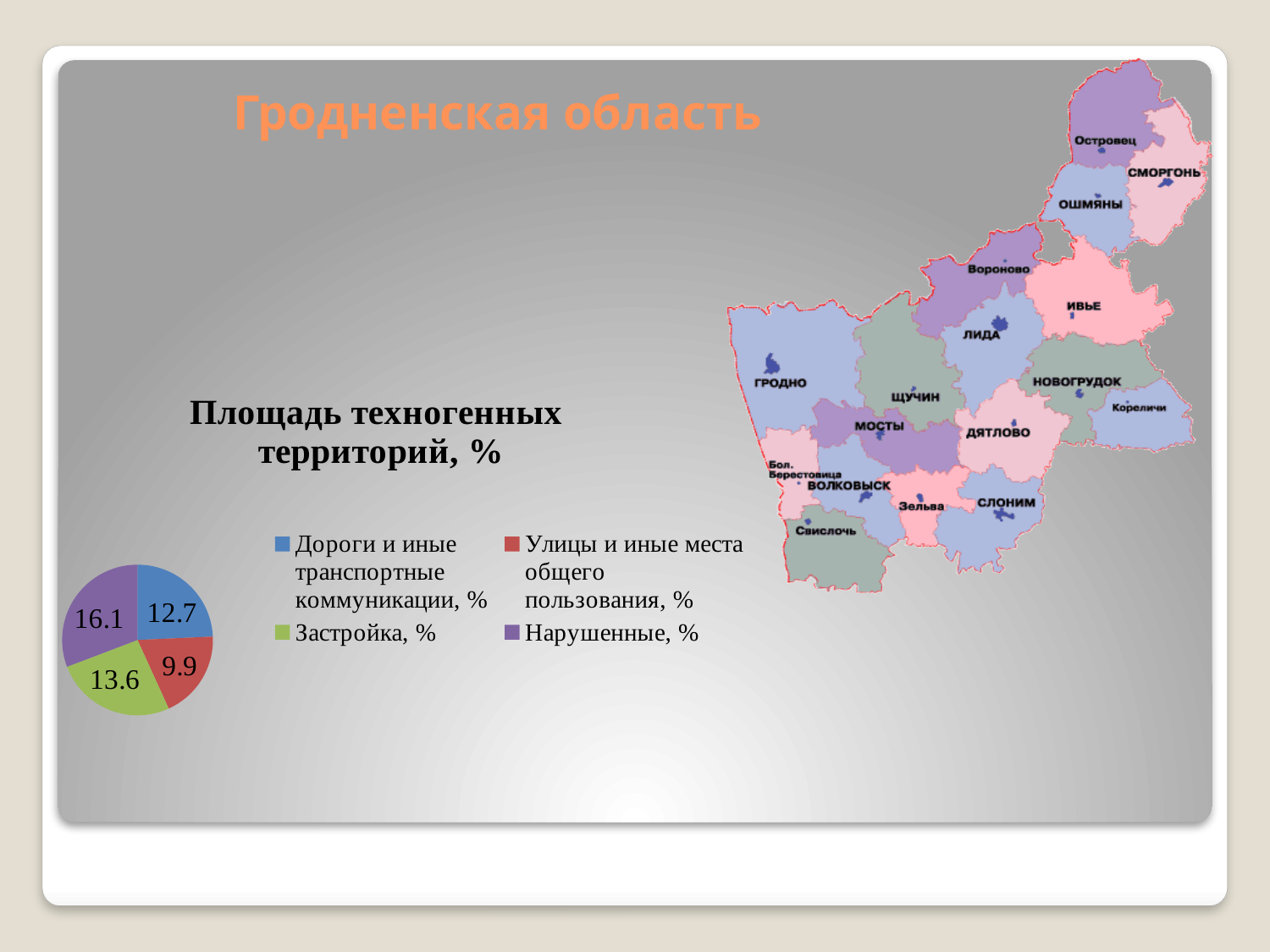
How many slices does the pie chart have? 4 What is the value for Дороги и иные транспортные коммуникации, % in the pie chart? 12.7 What type of chart is shown on the slide? Pie chart What is the value for Нарушенные, % in the pie chart? 16.1 Which is larger: the value for Застройка, % or the value for Дороги и иные транспортные коммуникации, %? Застройка, % Which category has the largest slice in the pie chart? Нарушенные, % What is the value for Застройка, % in the pie chart? 13.6 What is the title of the chart on the slide? Площадь техногенных территорий, % What is the difference between the values for Нарушенные, % and Улицы и иные места общего пользования, %? 6.2 Which category has the smallest slice in the pie chart? Улицы и иные места общего пользования, % What is the value for Улицы и иные места общего пользования, % in the pie chart? 9.9 What is the difference between the values for Застройка, % and Дороги и иные транспортные коммуникации, %? 0.9